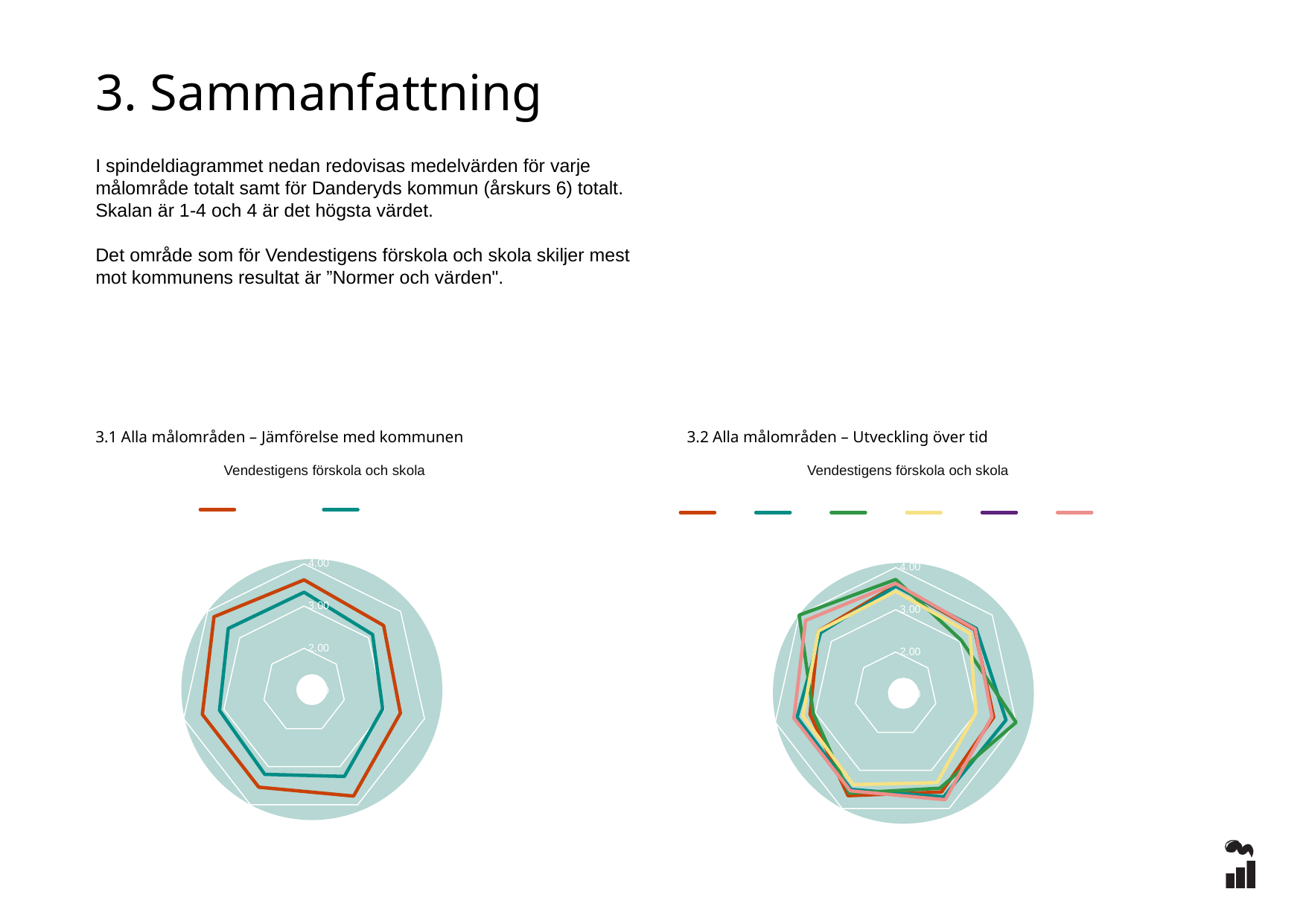
How many axes (categories) does the radar chart under heading 3.1 have? 7 What kind of chart is shown under heading 3.2 Alla målområden – Utveckling över tid? Radar chart What kind of chart is shown under heading 3.1 Alla målområden – Jämförelse med kommunen? Radar chart In the chart under heading 3.1 Alla målområden – Jämförelse med kommunen, which series lies further from the centre on every axis, the orange one or the teal one? The orange one In the chart under heading 3.2 Alla målområden – Utveckling över tid, how many series does the legend list? 6 What is the title printed above the chart under heading 3.1 Alla målområden – Jämförelse med kommunen? Vendestigens förskola och skola In the chart under heading 3.1 Alla målområden – Jämförelse med kommunen, how many series does the legend list? 2 What is the highest axis tick value shown on the radar chart under heading 3.2 Alla målområden – Utveckling över tid? 4,00 How many axes (categories) does the radar chart under heading 3.2 have? 7 How many charts are on the slide? 2